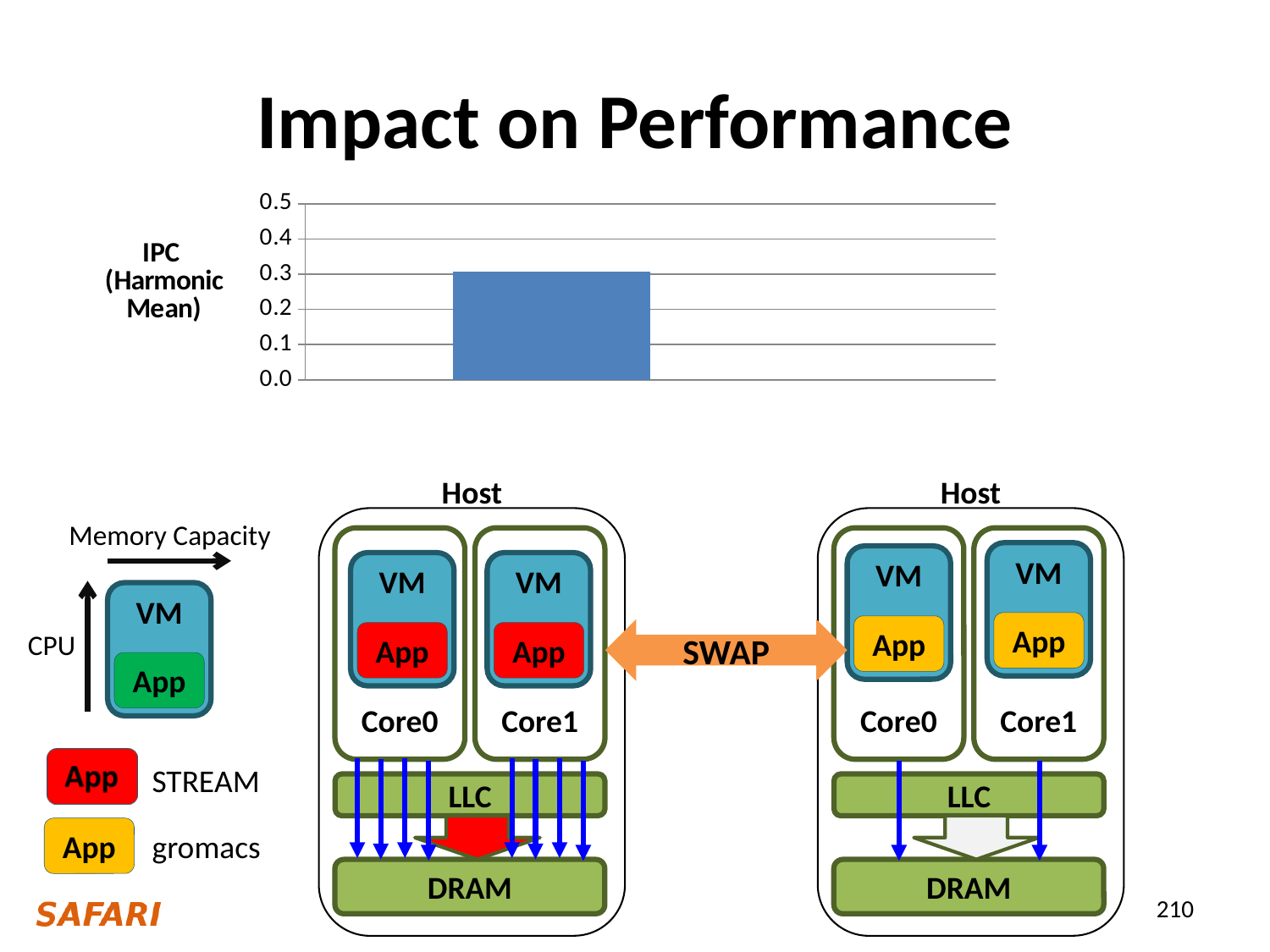
What is the label of the vertical axis of the chart? IPC (Harmonic Mean) Is the value of the bar in the chart greater or less than 0.2? greater Is the value of the bar in the chart greater or less than 0.1? greater Is the value of the bar in the chart greater or less than 0.5? less What kind of chart is shown on the slide? bar chart How many bars are plotted in the chart? 1 What is the maximum value shown on the vertical axis of the chart? 0.5